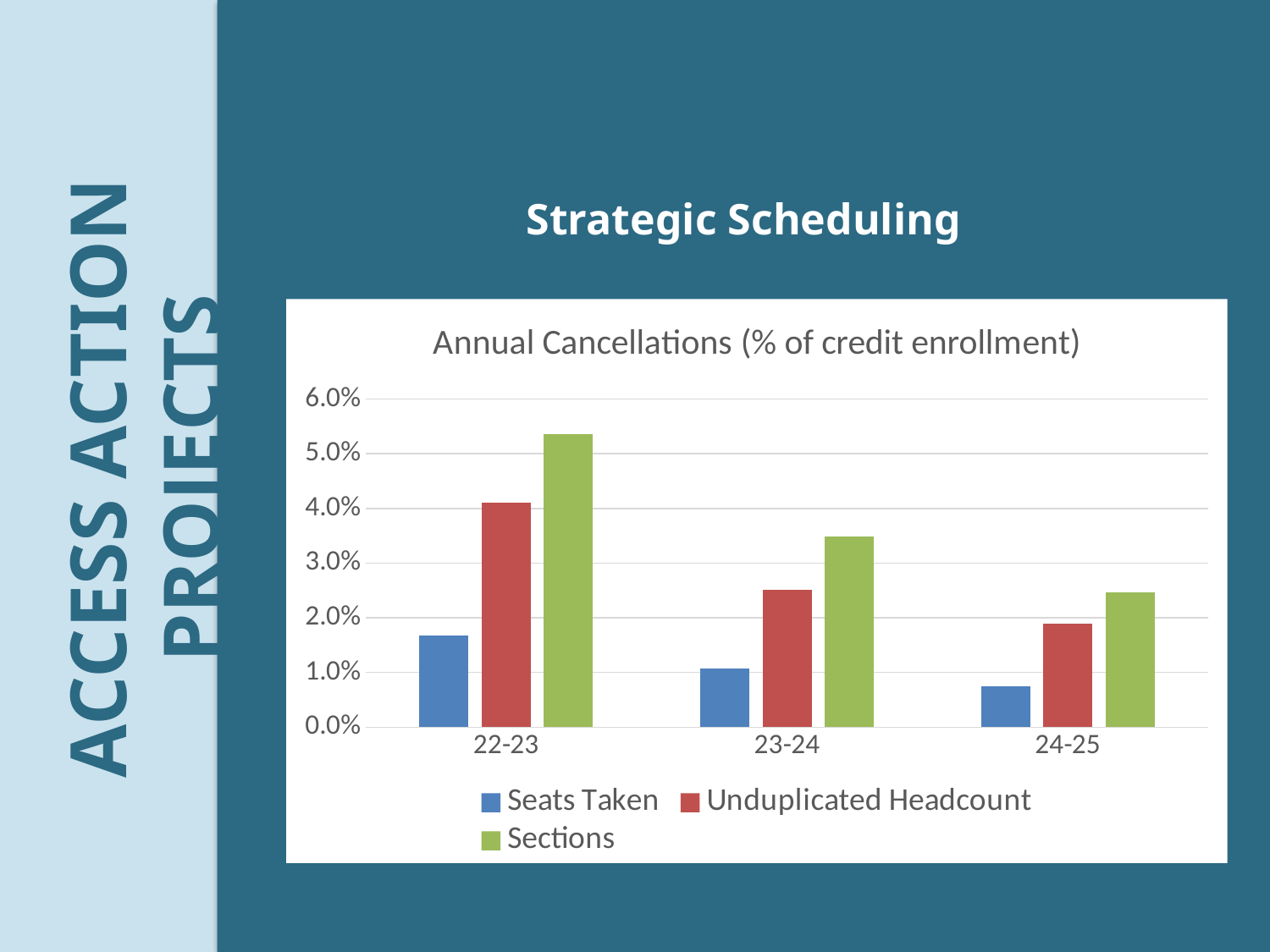
Is the value for Sections in 23-24 greater or less than 3.0%? greater What kind of chart is shown on the slide? Bar chart Do the Sections values rise or fall from 22-23 to 24-25? Fall Is the value for Sections in 22-23 greater or less than 5.0%? greater How many series does the legend list? 3 Which series has the lowest value in 24-25? Seats Taken What is the title of the chart? Annual Cancellations (% of credit enrollment) Is the value for Seats Taken in 24-25 greater or less than 1.0%? less How many academic-year categories are shown on the x axis? 3 Which series has the highest value in 22-23? Sections Which is larger: Unduplicated Headcount in 22-23 or Sections in 23-24? Unduplicated Headcount in 22-23